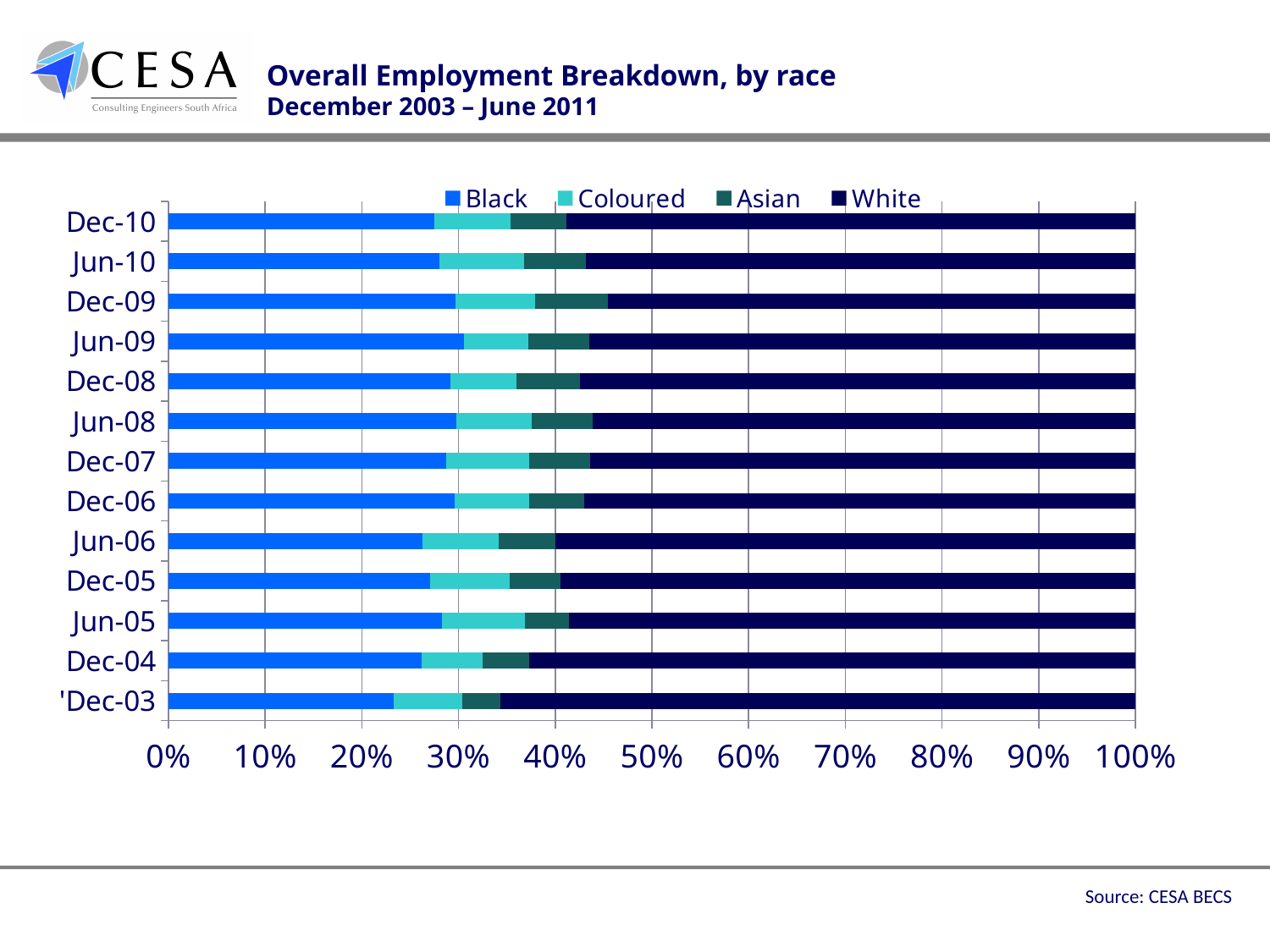
How many series does the legend list? 4 What is the title of the chart? Overall Employment Breakdown, by race December 2003 – June 2011 Is the White share for Dec-09 greater or less than 50%? greater Which series are listed in the legend? Black, Coloured, Asian, White Which period has the lowest Black share? 'Dec-03 Which is larger, the Black share for 'Dec-03 or the Black share for Dec-10? Dec-10 Which is larger, the White share for 'Dec-03 or the White share for Dec-09? 'Dec-03 What kind of chart is shown on the slide? Stacked bar chart Is the White share for 'Dec-03 greater or less than 60%? greater How many time periods (bars) are shown on the chart? 13 Is the Black share for 'Dec-03 greater or less than 30%? less